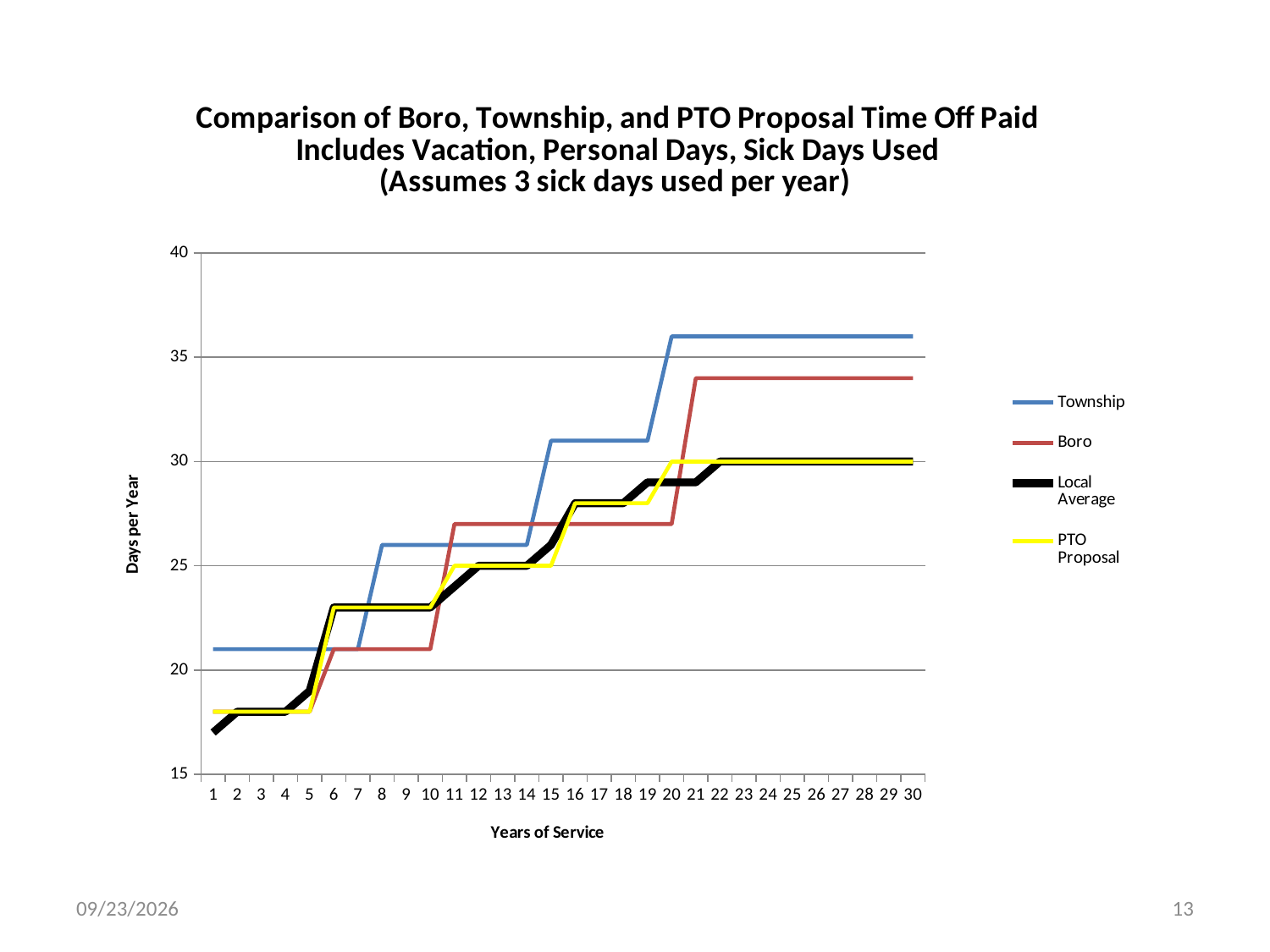
At year 30, which is larger, Boro or PTO Proposal? Boro Which series has the highest value at year 30? Township How many series does the legend list? 4 Do the values for Township rise or fall as years of service increase? rise Is the Boro value at year 30 greater or less than 35? less Is the Boro value at year 1 greater or less than 20? less Is the Township value at year 30 greater or less than 35? greater What kind of chart is shown on the slide? line chart How many years of service are shown along the x axis? 30 What is the title of the vertical axis? Days per Year Which series has the highest value at year 1? Township